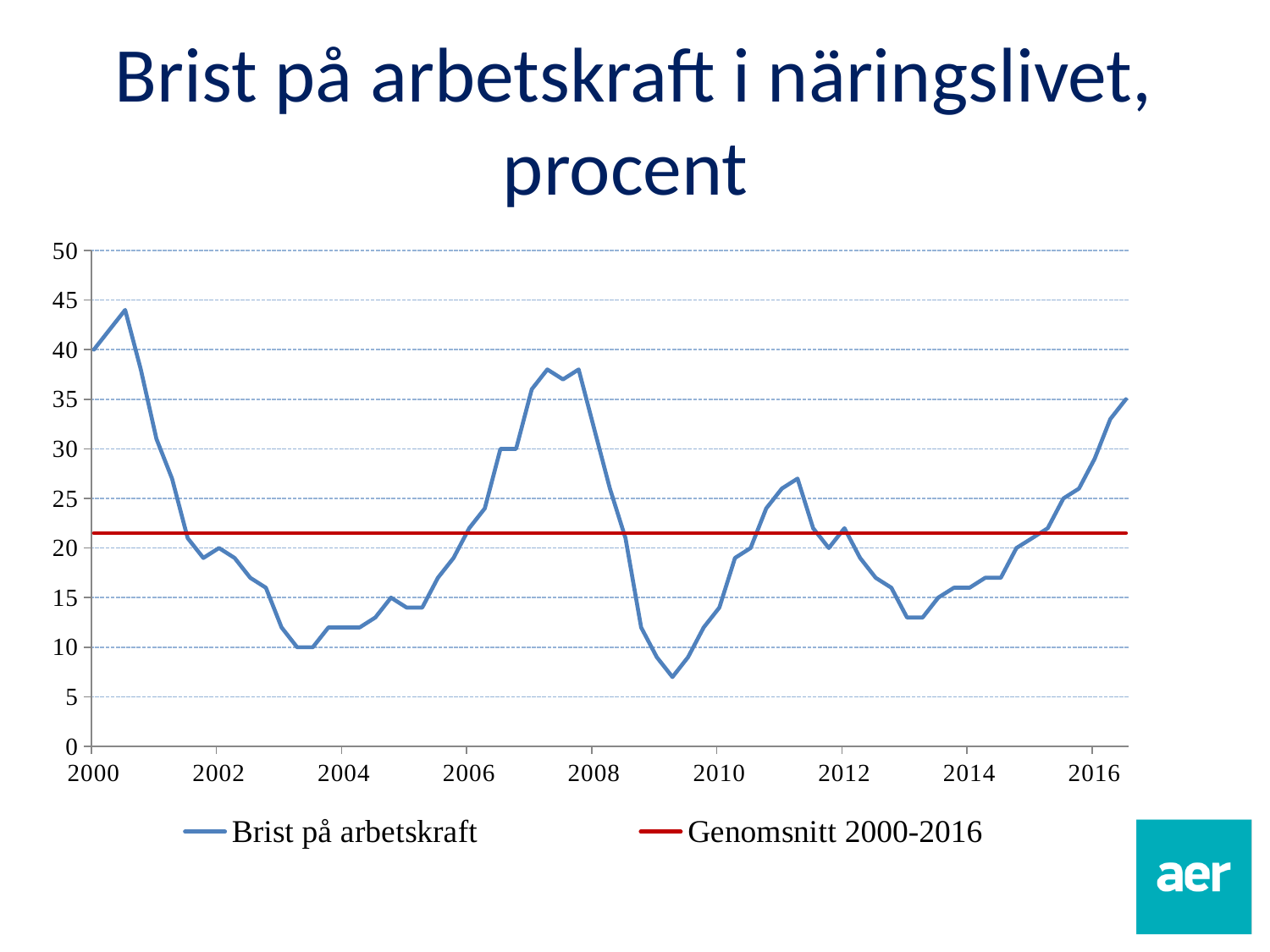
What kind of chart is shown on the slide? line chart Does the Brist på arbetskraft line rise or fall between 2000 and 2002? fall Is the value for Brist på arbetskraft at 2004 greater or less than 15? less Is the value for Brist på arbetskraft at 2016 greater or less than 20? greater Which is larger, the value for Brist på arbetskraft at 2000 or at 2004? 2000 Does the Brist på arbetskraft line rise or fall between 2014 and 2016? rise Is the value for Brist på arbetskraft at 2000 greater or less than 35? greater How many series does the legend list? 2 What does the red line in the chart represent, according to the legend? Genomsnitt 2000-2016 What is the title of the chart? Brist på arbetskraft i näringslivet, procent